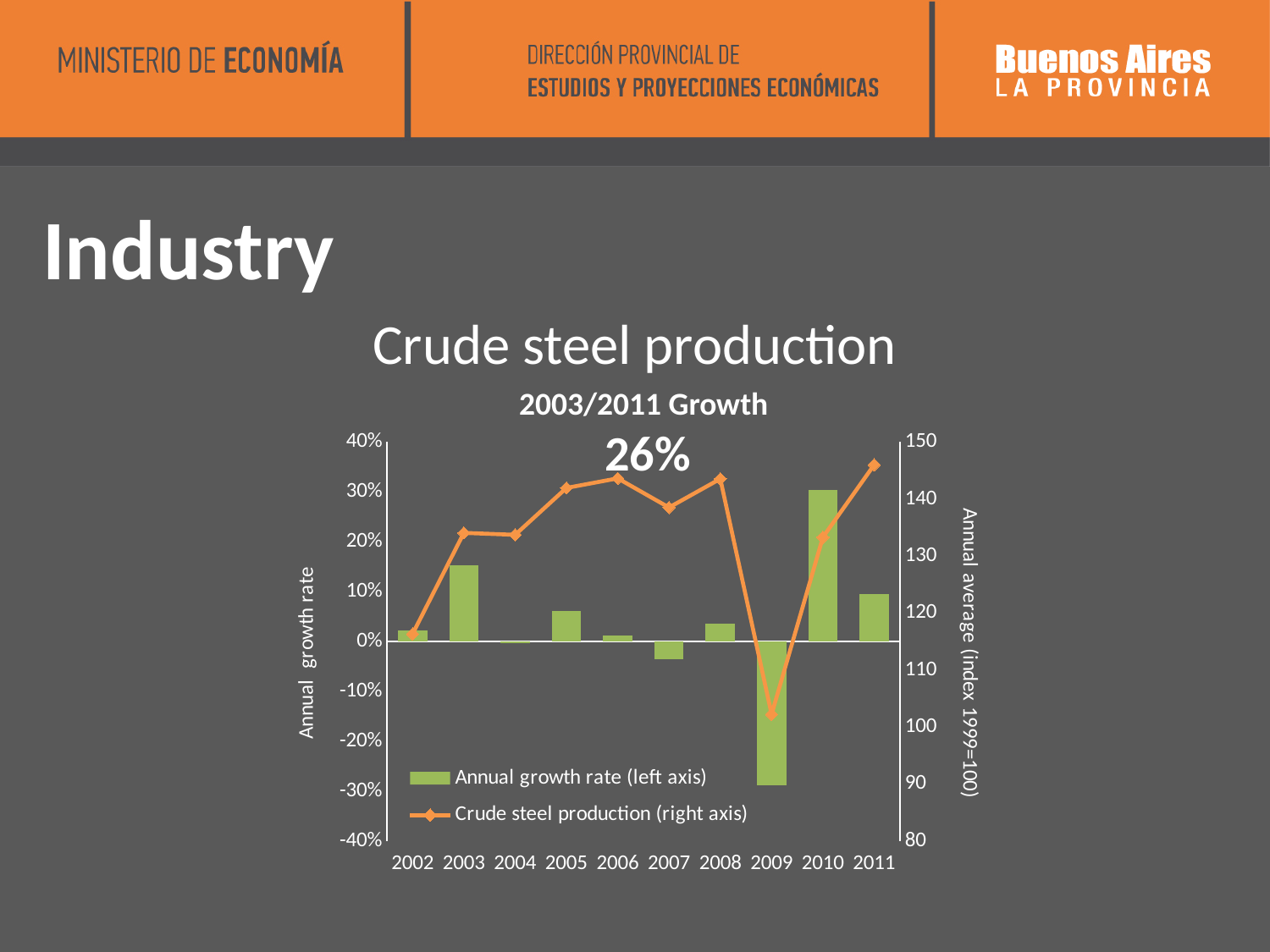
In which year is the annual growth rate bar the highest? 2010 How many series does the chart legend list? 2 Is the annual growth rate for 2009 greater or less than -20%? less What is the 2003/2011 growth figure printed on the chart? 26% In which year is the annual growth rate bar the lowest? 2009 Is the annual growth rate for 2010 greater or less than 20%? greater How many years are shown on the x axis of the chart? 10 What kind of chart is shown on the slide? A combined bar and line chart Is the crude steel production index for 2009 greater or less than 110? less Which is larger, the annual growth rate for 2003 or for 2010? 2010 Does the crude steel production line rise or fall from 2002 to 2006? rise In which year does the crude steel production line reach its highest point? 2011